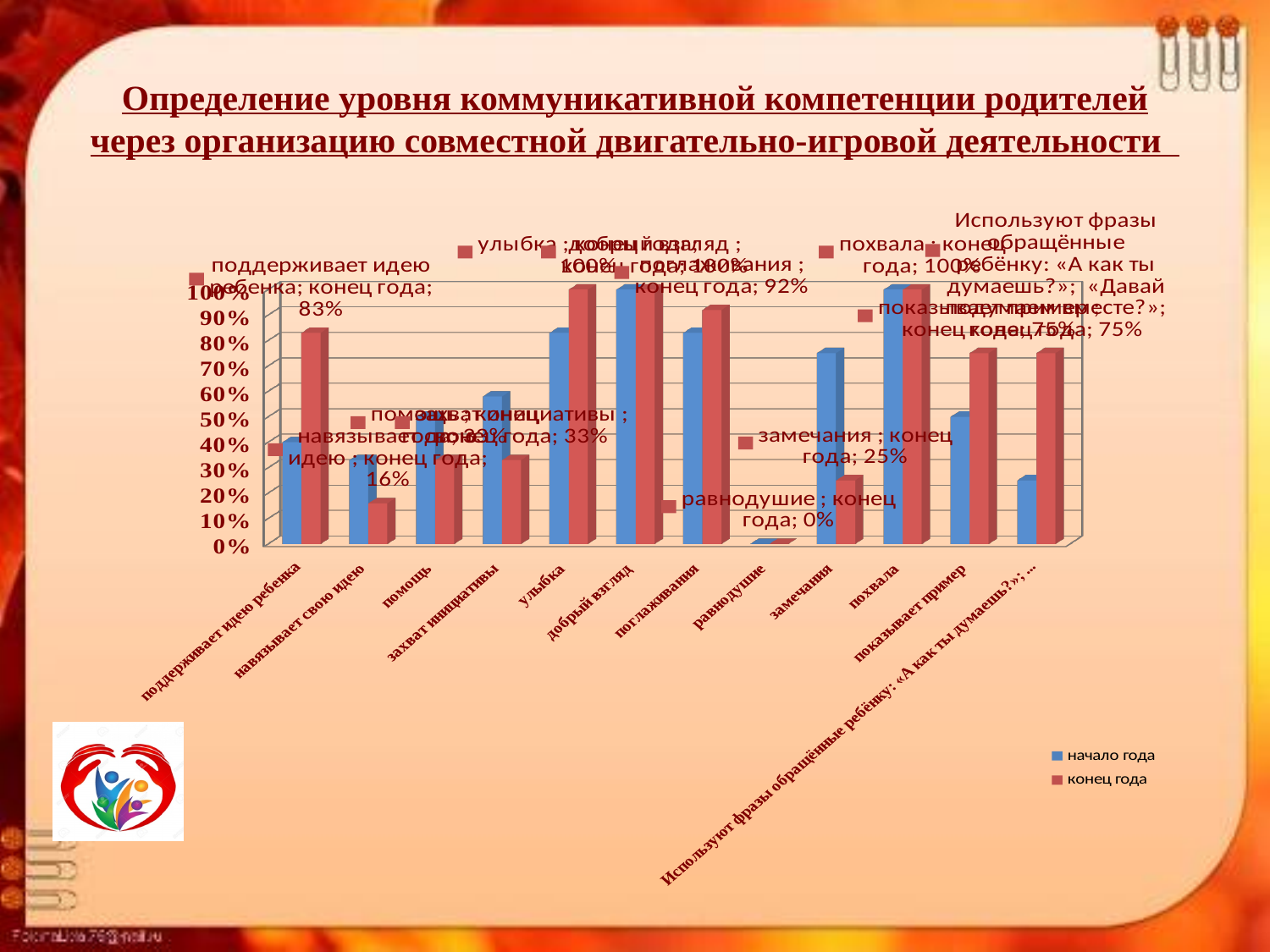
What is the value of 'конец года' for 'поглаживания'? 92% What is the value of 'конец года' for 'показывает пример'? 75% What is the value of 'конец года' for 'замечания'? 25% What kind of chart is shown on the slide? bar chart Is the 'начало года' value for 'замечания' greater or less than 50%? greater How many categories are shown along the x axis of the chart? 12 What is the value of 'конец года' for 'навязывает свою идею'? 16% Which category has the lowest 'конец года' value? равнодушие For 'замечания', which series has the larger value, 'начало года' or 'конец года'? начало года What is the value of 'конец года' for 'поддерживает идею ребенка'? 83% What is the difference between the 'конец года' values for 'поддерживает идею ребенка' and 'навязывает свою идею'? 67 percentage points How many series does the chart legend list? 2